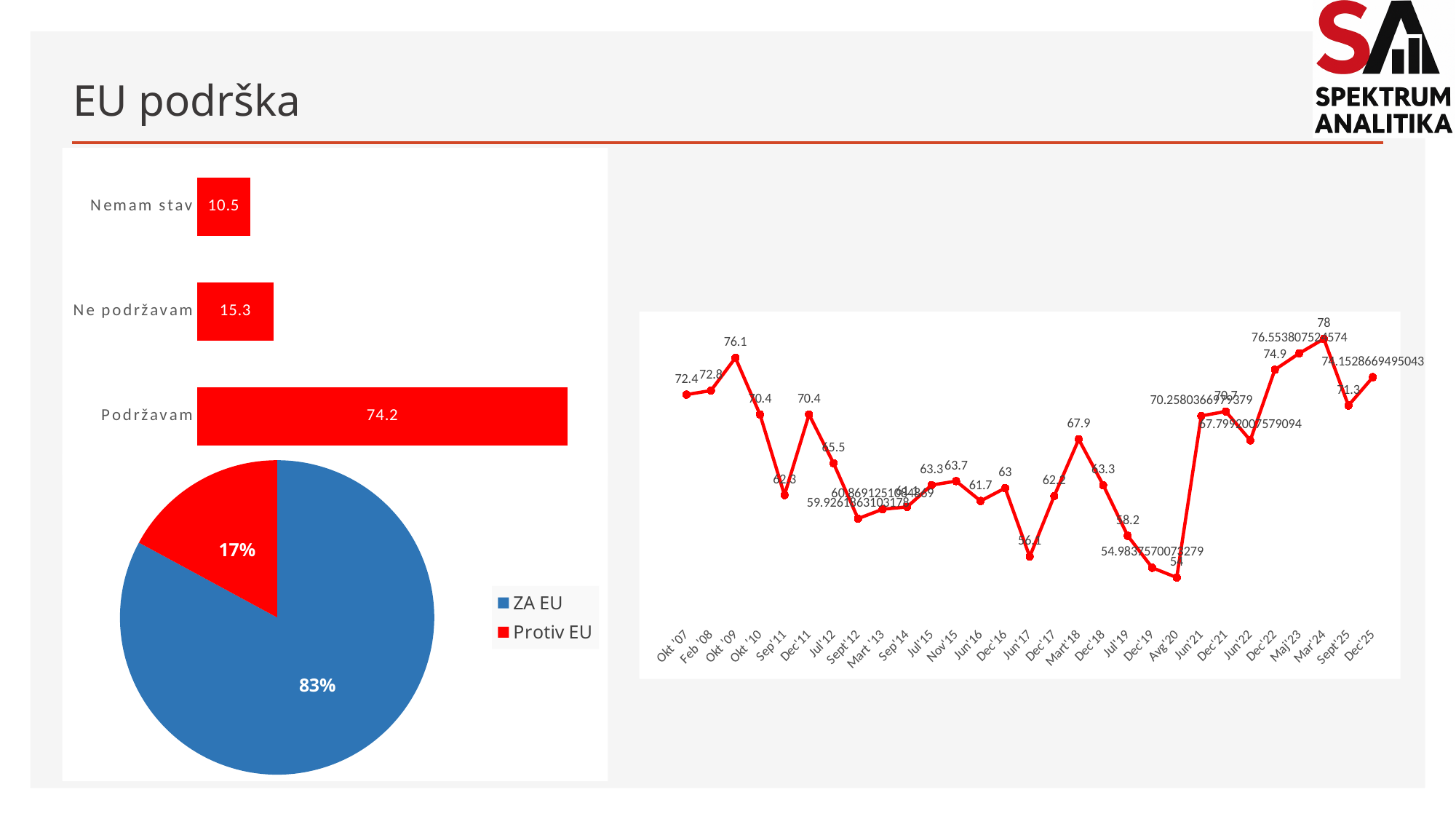
In the bar chart on the left, what is the difference between Podržavam and Ne podržavam? 58.9 What kind of chart is the chart on the right side of the slide? Line chart How many entries does the legend of the pie chart list? 2 In the pie chart, what share does ZA EU have? 83% In the line chart on the right, which point has the highest value? Mar'24 In the line chart on the right, what is the value for Okt '09? 76.1 In the bar chart on the left, which category has the lowest value? Nemam stav In the bar chart on the left, what is the value for Nemam stav? 10.5 In the pie chart, what share does Protiv EU have? 17% How many categories does the bar chart on the left show? 3 In the bar chart on the left, what is the value for Podržavam? 74.2 In the line chart on the right, which is larger, the value for Okt '09 or the value for Okt '10? Okt '09